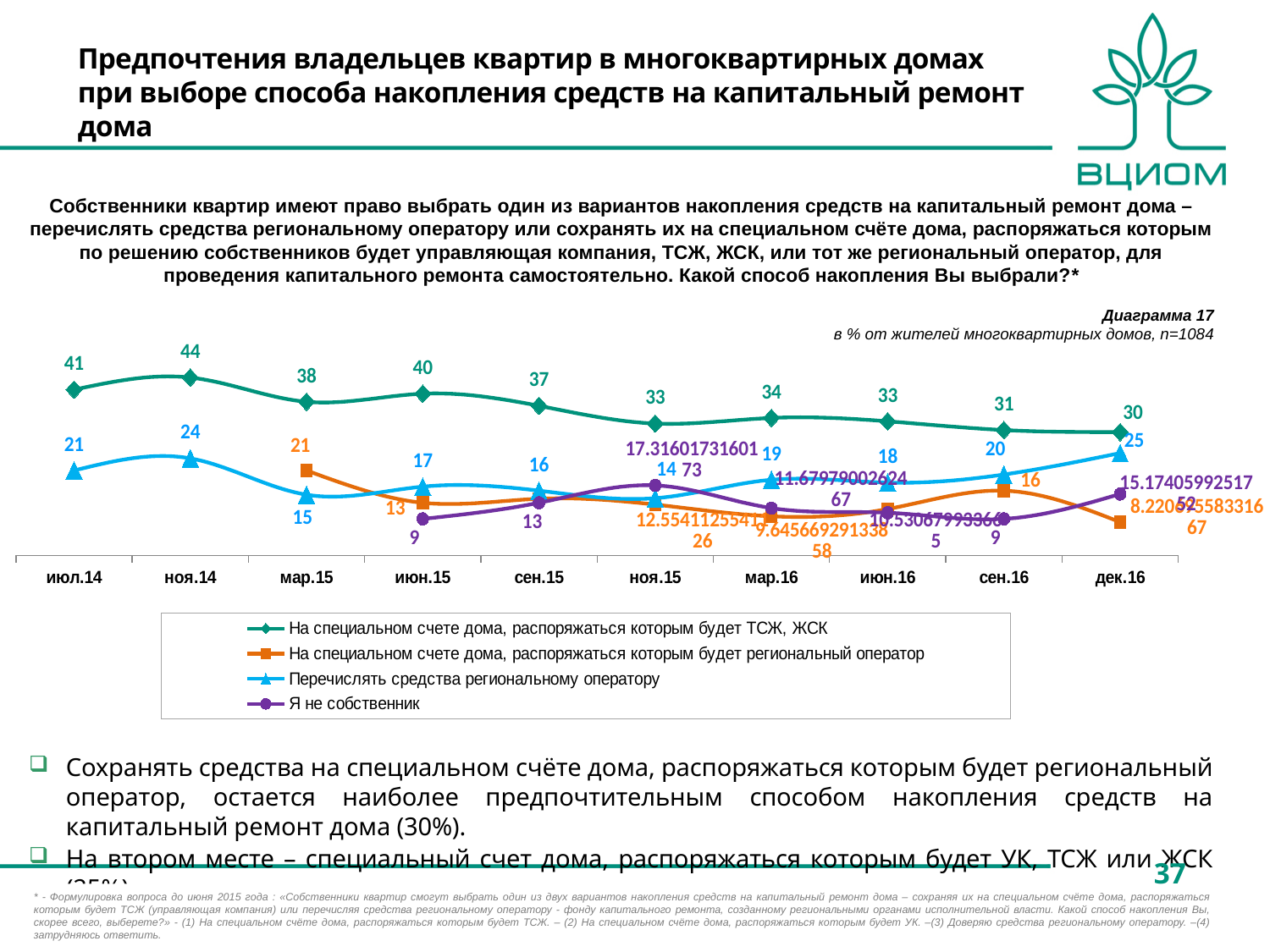
What is the value for 'Перечислять средства региональному оператору' in дек.16? 25 What is the value for 'На специальном счете дома, распоряжаться которым будет ТСЖ, ЖСК' in сен.16? 31 In which period does the series 'На специальном счете дома, распоряжаться которым будет ТСЖ, ЖСК' reach its highest value? ноя.14 In which period does the series 'На специальном счете дома, распоряжаться которым будет ТСЖ, ЖСК' have its lowest value? дек.16 What is the difference between the values of 'На специальном счете дома, распоряжаться которым будет ТСЖ, ЖСК' in июл.14 and дек.16? 11 In июл.14, which is larger: 'На специальном счете дома, распоряжаться которым будет ТСЖ, ЖСК' or 'Перечислять средства региональному оператору'? На специальном счете дома, распоряжаться которым будет ТСЖ, ЖСК Does the series 'На специальном счете дома, распоряжаться которым будет ТСЖ, ЖСК' generally rise or fall from июл.14 to дек.16? fall How many time points are shown on the x axis? 10 What is the value for 'На специальном счете дома, распоряжаться которым будет региональный оператор' in мар.15? 21 What is the value for 'На специальном счете дома, распоряжаться которым будет ТСЖ, ЖСК' in ноя.14? 44 What kind of chart is shown on the slide? line chart How many series does the legend list? 4